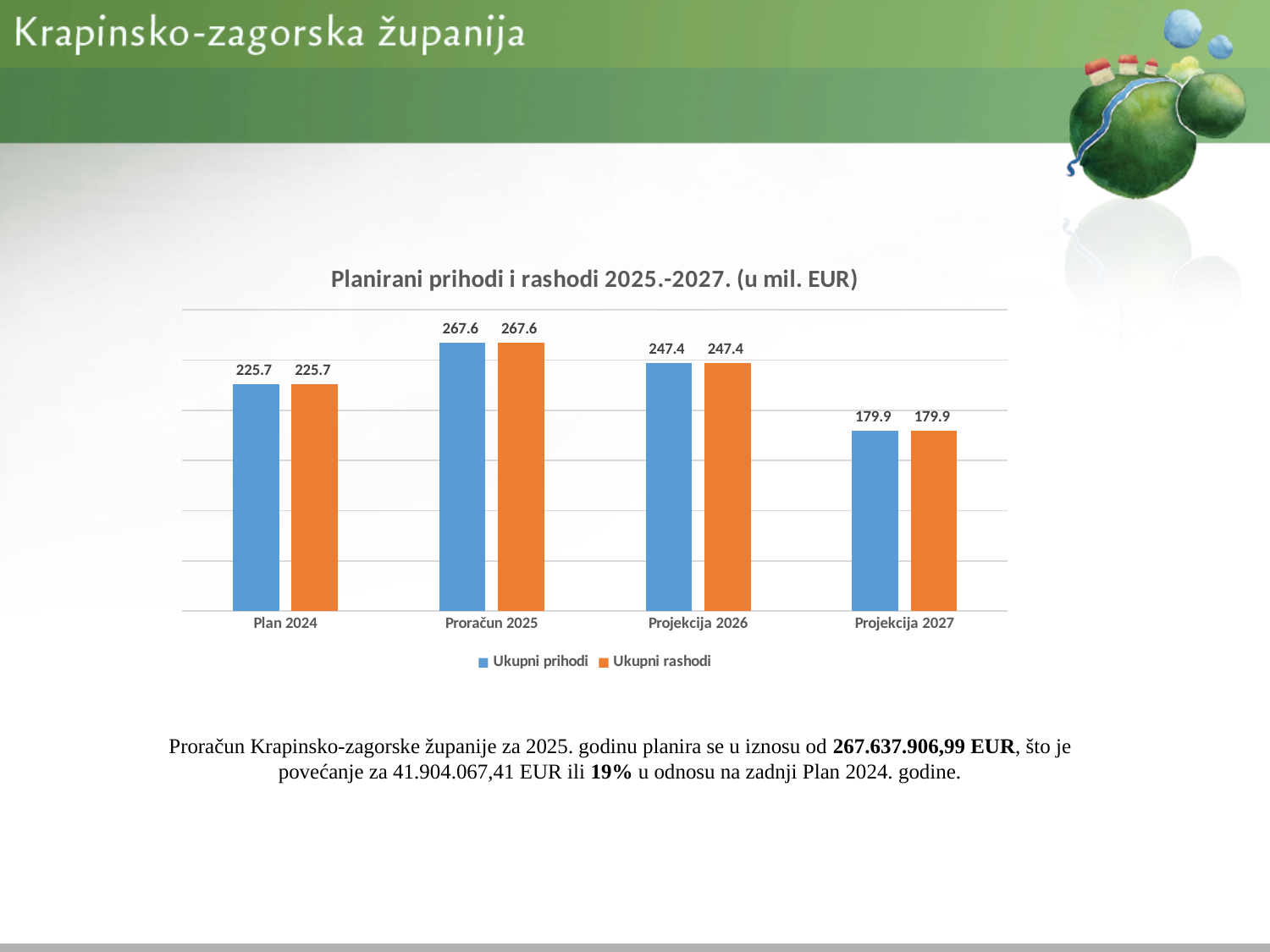
What is the value of Ukupni prihodi for Plan 2024? 225.7 What is the value of Ukupni rashodi for Projekcija 2027? 179.9 Do the Ukupni rashodi values rise or fall from Proračun 2025 to Projekcija 2027? Fall What is the value of Ukupni prihodi for Proračun 2025? 267.6 How many categories are shown on the x axis? 4 What is the title of the chart? Planirani prihodi i rashodi 2025.-2027. (u mil. EUR) Which category has the highest Ukupni prihodi value? Proračun 2025 How many series does the legend list? 2 What kind of chart is shown on the slide? Bar chart Which is larger: Ukupni prihodi for Projekcija 2026 or for Projekcija 2027? Projekcija 2026 What is the difference between Ukupni prihodi for Proračun 2025 and Plan 2024? 41.9 Which category has the lowest Ukupni rashodi value? Projekcija 2027